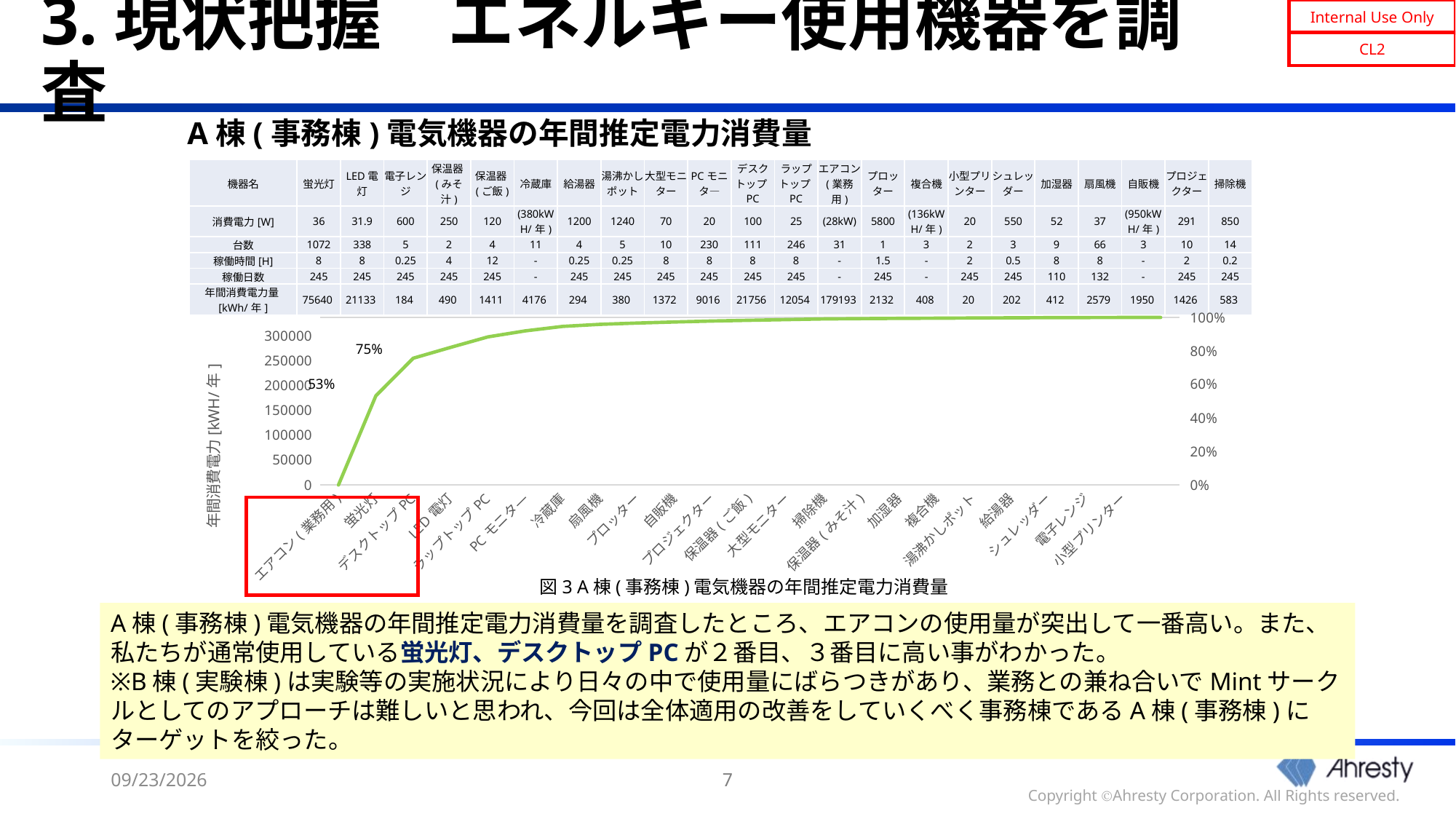
According to the table above the chart, which device has the highest annual power consumption (年間消費電力量)? エアコン(業務用) What kind of chart is shown on the slide? line chart Does the green line rise or fall as you move from left to right along the x axis? rise What is the second cumulative percentage data label shown on the green line? 75% According to the table above the chart, which has the larger annual power consumption, 蛍光灯 or デスクトップPC? 蛍光灯 According to the table above the chart, what is the difference in annual power consumption between エアコン(業務用) (179193) and 蛍光灯 (75640)? 103553 Which category appears first on the x axis of the chart? エアコン(業務用) What is the first cumulative percentage data label shown on the green line? 53% How many categories are listed along the x axis of the chart? 22 What is the highest tick value on the left vertical axis of the chart? 300000 Is the cumulative percentage at the last category (小型プリンター) greater or less than 80%? greater According to the table above the chart, what is the annual power consumption (年間消費電力量) of エアコン(業務用)? 179193